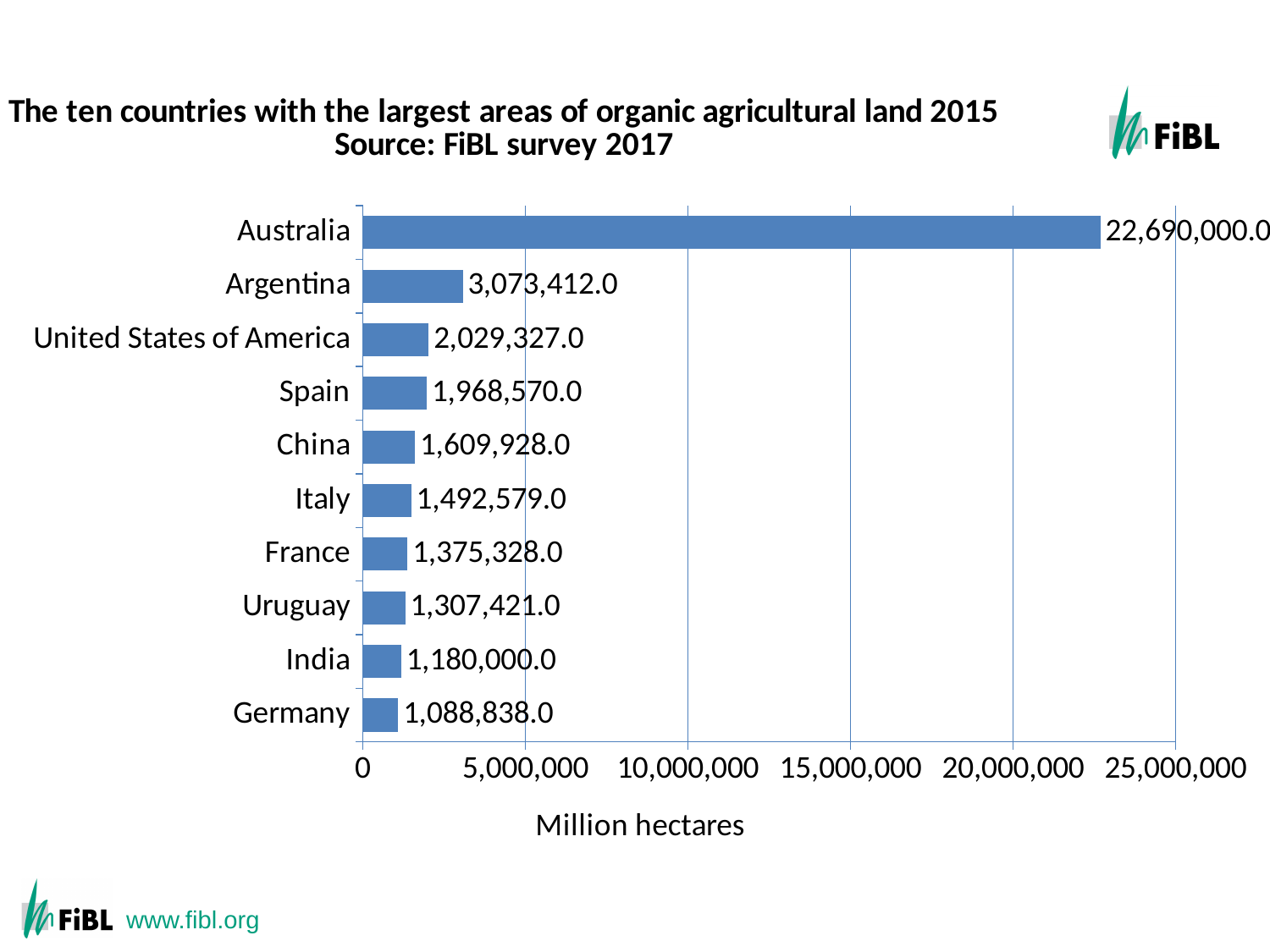
What is the difference between the values for Australia and Argentina? 19,616,588.0 What is the value shown for Uruguay? 1,307,421.0 Which country has the smallest value in the chart? Germany What is the value shown for Germany? 1,088,838.0 What is the difference between the values for Spain and China? 358,642.0 Which country has the largest area of organic agricultural land in the chart? Australia Which has a larger value, the United States of America or Italy? United States of America What kind of chart is shown on the slide? bar chart How many countries are shown in the chart? 10 What is the value shown for Australia? 22,690,000.0 Is the value for Australia greater or less than 20,000,000? greater What is the value shown for Argentina? 3,073,412.0